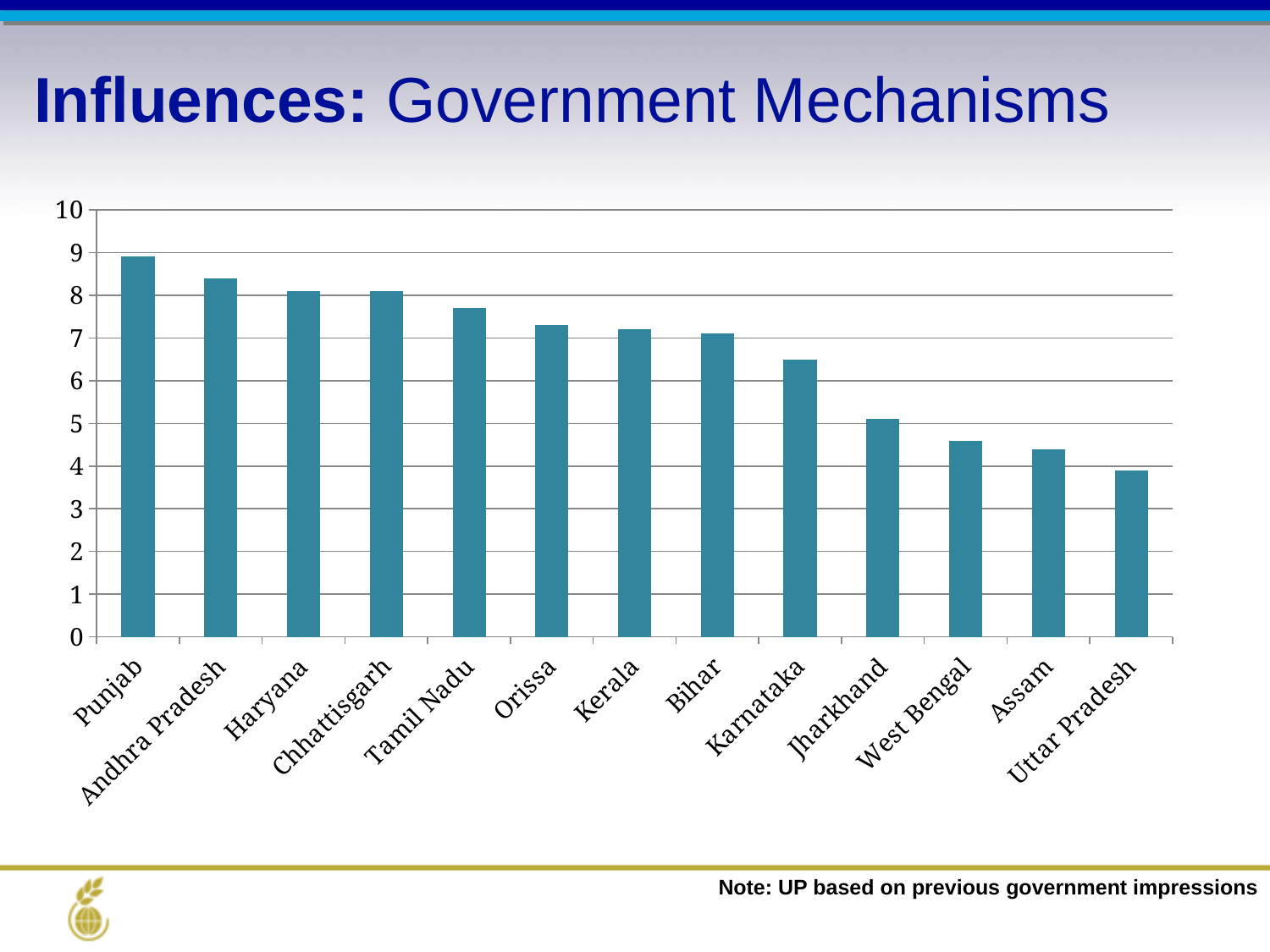
Which has the larger value, Karnataka or Jharkhand? Karnataka Is the value for Karnataka greater or less than 6? greater Which state has the highest value on the chart? Punjab Do the values rise or fall moving from left to right along the x axis? fall How many states are plotted on the chart? 13 Which has the larger value, Andhra Pradesh or Orissa? Andhra Pradesh Is the value for West Bengal greater or less than 5? less Is the value for Tamil Nadu greater or less than 7? greater What kind of chart is shown on the slide? bar chart Which state has the lowest value on the chart? Uttar Pradesh What is the title of the slide containing the chart? Influences: Government Mechanisms